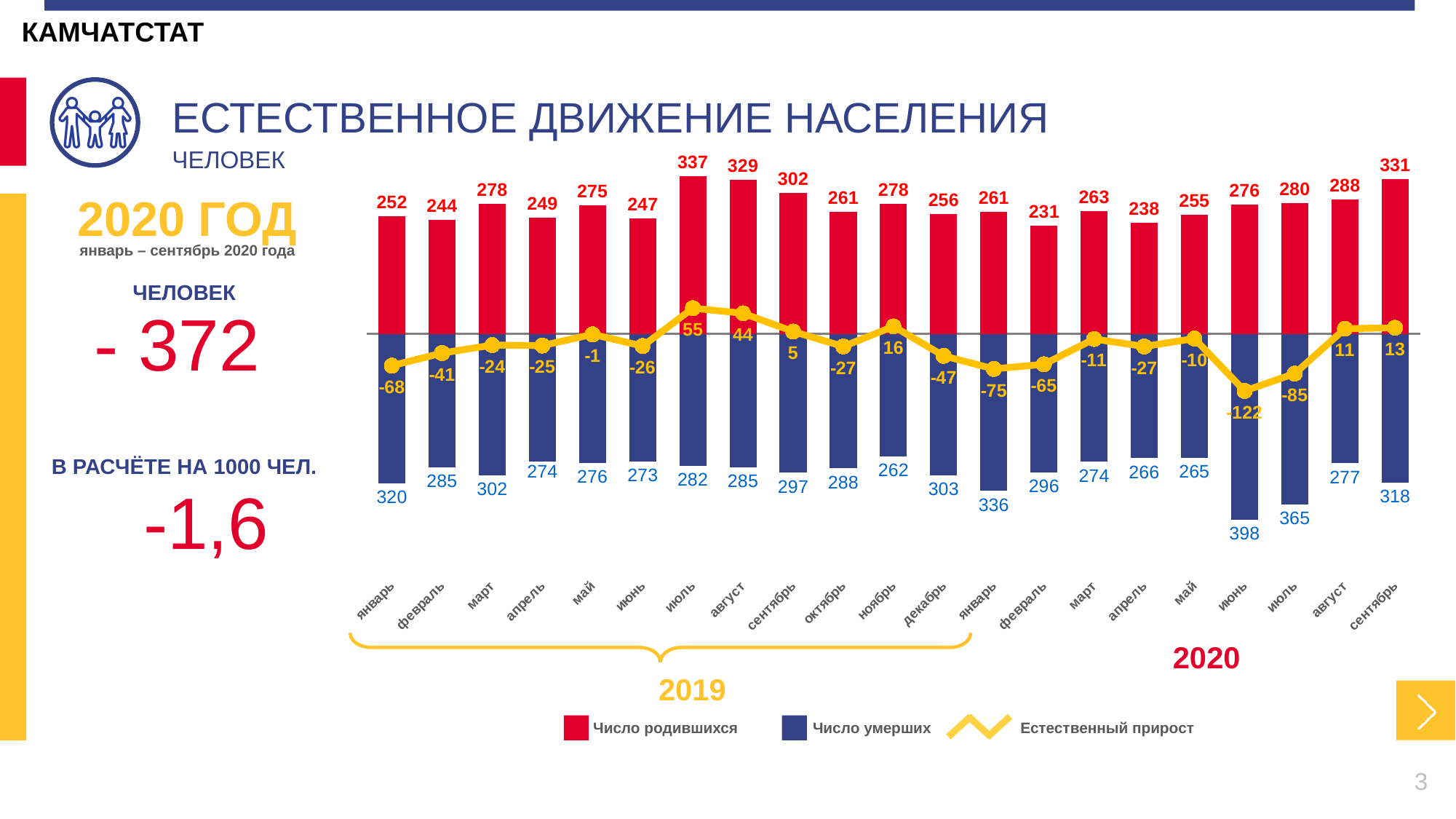
How many series does the legend list? 3 Which month has the highest number of births (Число родившихся)? июль 2019 What is the difference in births between September 2020 (331) and September 2019 (302)? 29 How many months are plotted on the x axis? 21 Which January had more deaths (Число умерших): January 2019 or January 2020? январь 2020 Which month has the highest number of deaths (Число умерших)? июнь 2020 What is the natural increase (Естественный прирост) value for June 2020 (июнь)? -122 Which month has the lowest number of births (Число родившихся)? февраль 2020 How many births (Число родившихся) are shown for July 2019 (июль)? 337 How many deaths (Число умерших) are shown for June 2020 (июнь)? 398 What kind of chart is used for the births and deaths data? bar chart Which month has the lowest number of deaths (Число умерших)? ноябрь 2019